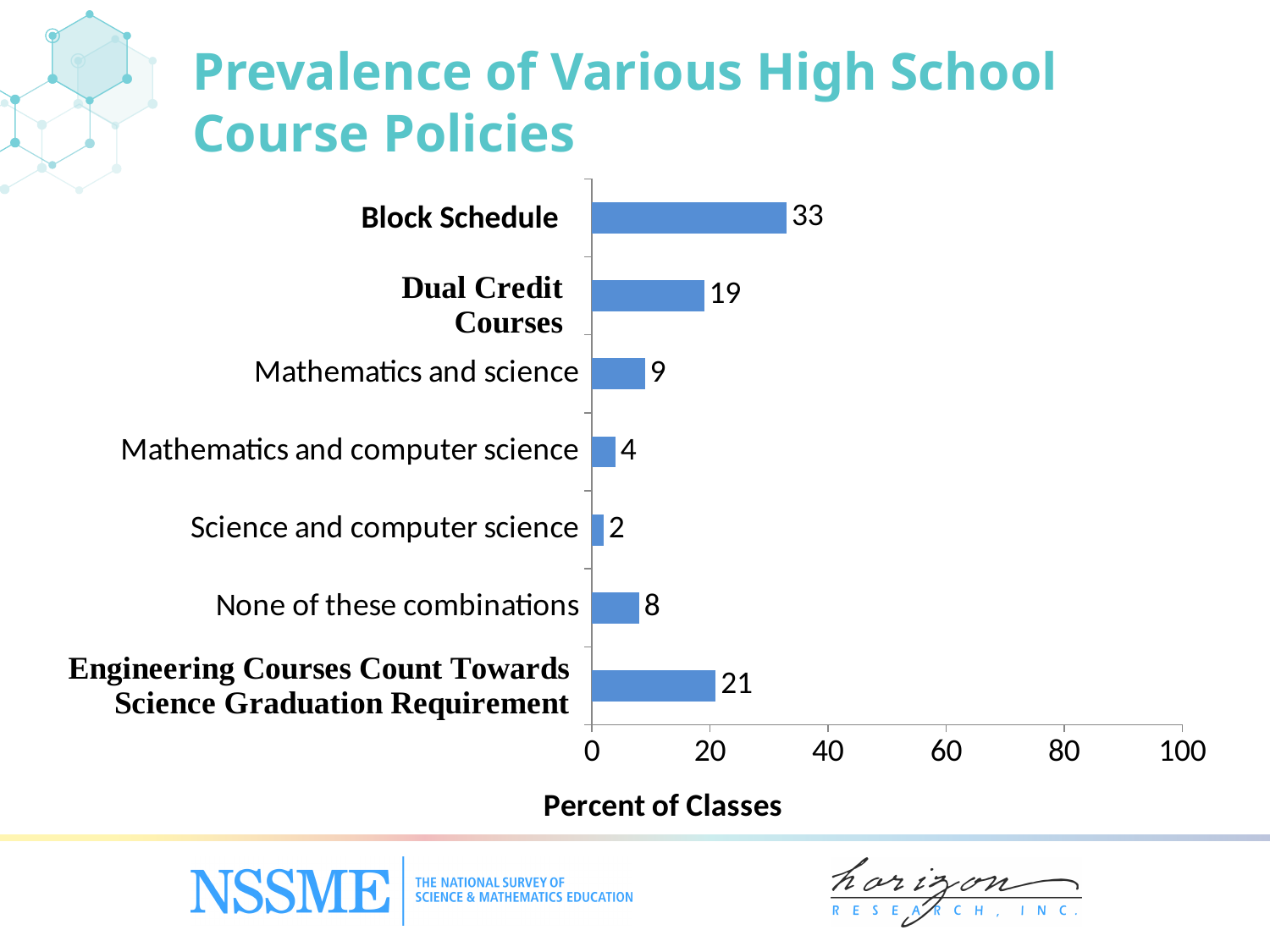
What is the difference between the values for Block Schedule and Dual Credit Courses? 14 How many categories are shown in the chart? 7 What is the label of the horizontal axis? Percent of Classes Is the value for Block Schedule greater or less than 40? less What is the value for Dual Credit Courses? 19 Which category has the highest value? Block Schedule Which is larger, the value for Mathematics and science or the value for None of these combinations? Mathematics and science What kind of chart is shown on the slide? bar chart What is the value for Science and computer science? 2 Which category has the lowest value? Science and computer science What is the value for Block Schedule? 33 What is the value for Engineering Courses Count Towards Science Graduation Requirement? 21